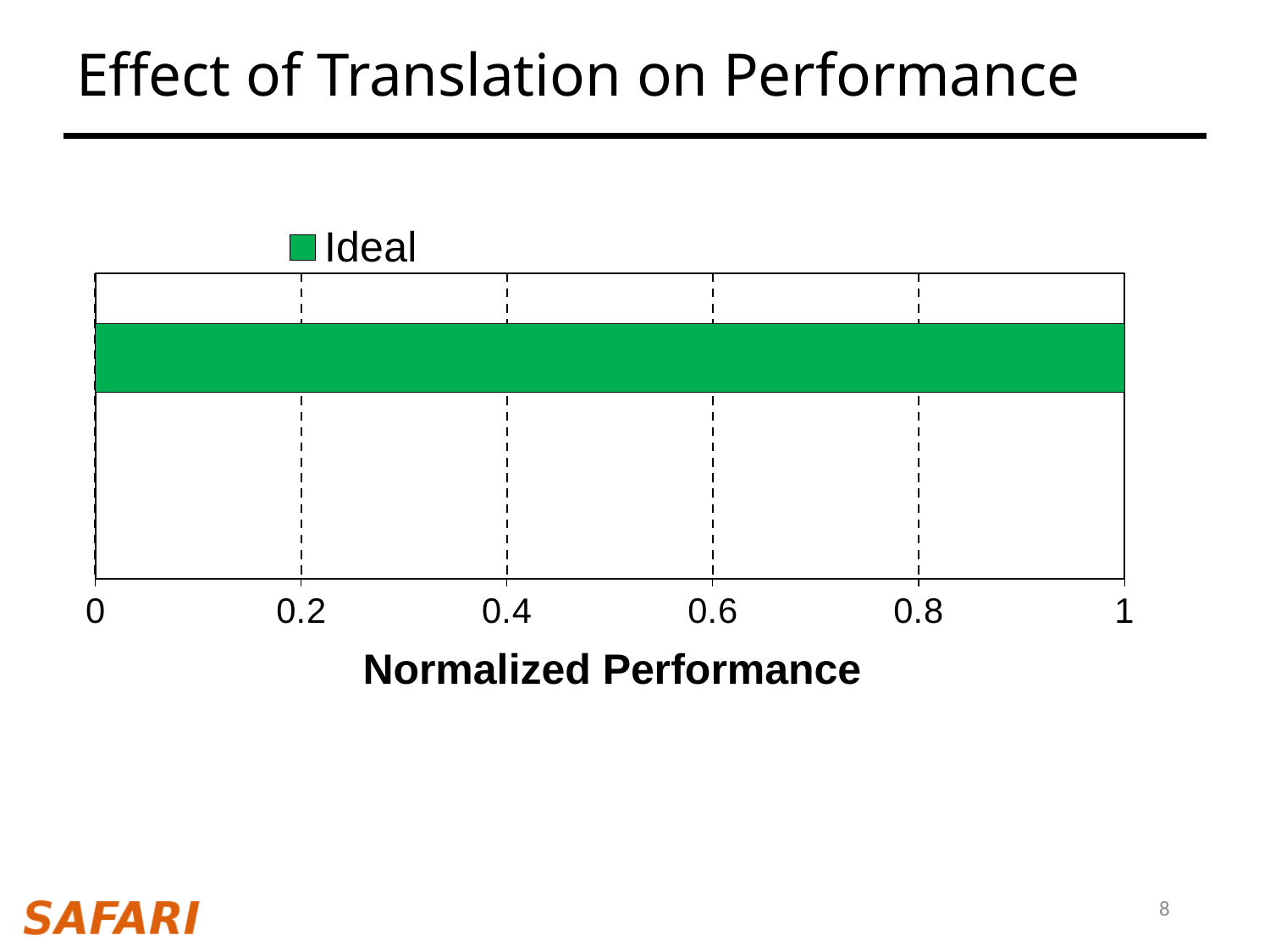
What is the normalized performance value for the Ideal bar? 1 What is the label of the x axis? Normalized Performance What is the highest value shown on the x axis? 1 How many series does the legend list? 1 What kind of chart is shown on the slide? bar chart How many bars are plotted in the chart? 1 Is the value for Ideal greater or less than 0.6? greater What is the lowest value shown on the x axis? 0 What is the name of the series shown in the legend? Ideal Is the value for Ideal greater or less than 0.8? greater